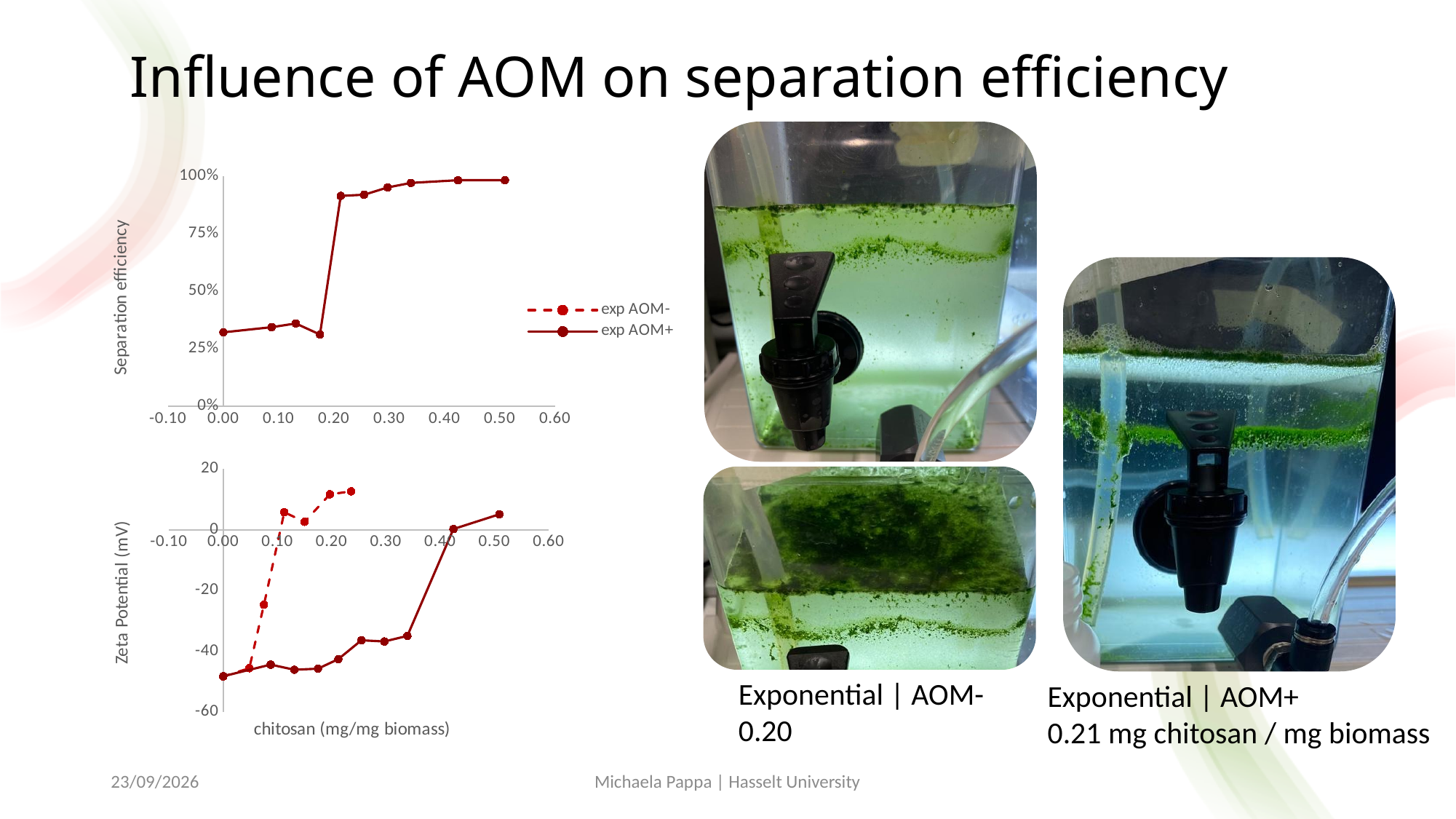
In the bottom chart (Zeta Potential), does the exp AOM- series rise or fall as chitosan increases? rise In the bottom chart (Zeta Potential), is the value for exp AOM+ at 0.00 chitosan greater or less than -40? less In the bottom chart (Zeta Potential), at 0.20 chitosan, which series has the larger value, exp AOM- or exp AOM+? exp AOM- In the bottom chart (Zeta Potential), is the value for exp AOM- at about 0.24 chitosan greater or less than 0? greater In the bottom chart (Zeta Potential), is the value for exp AOM+ at 0.50 chitosan greater or less than 0? greater In the top chart (Separation efficiency), does the exp AOM+ series rise or fall overall as chitosan increases? rise Which series is drawn with a dashed line in the legend? exp AOM- What is the x-axis label of the bottom chart? chitosan (mg/mg biomass) What kind of chart is the top chart showing separation efficiency? line chart How many series does the legend list? 2